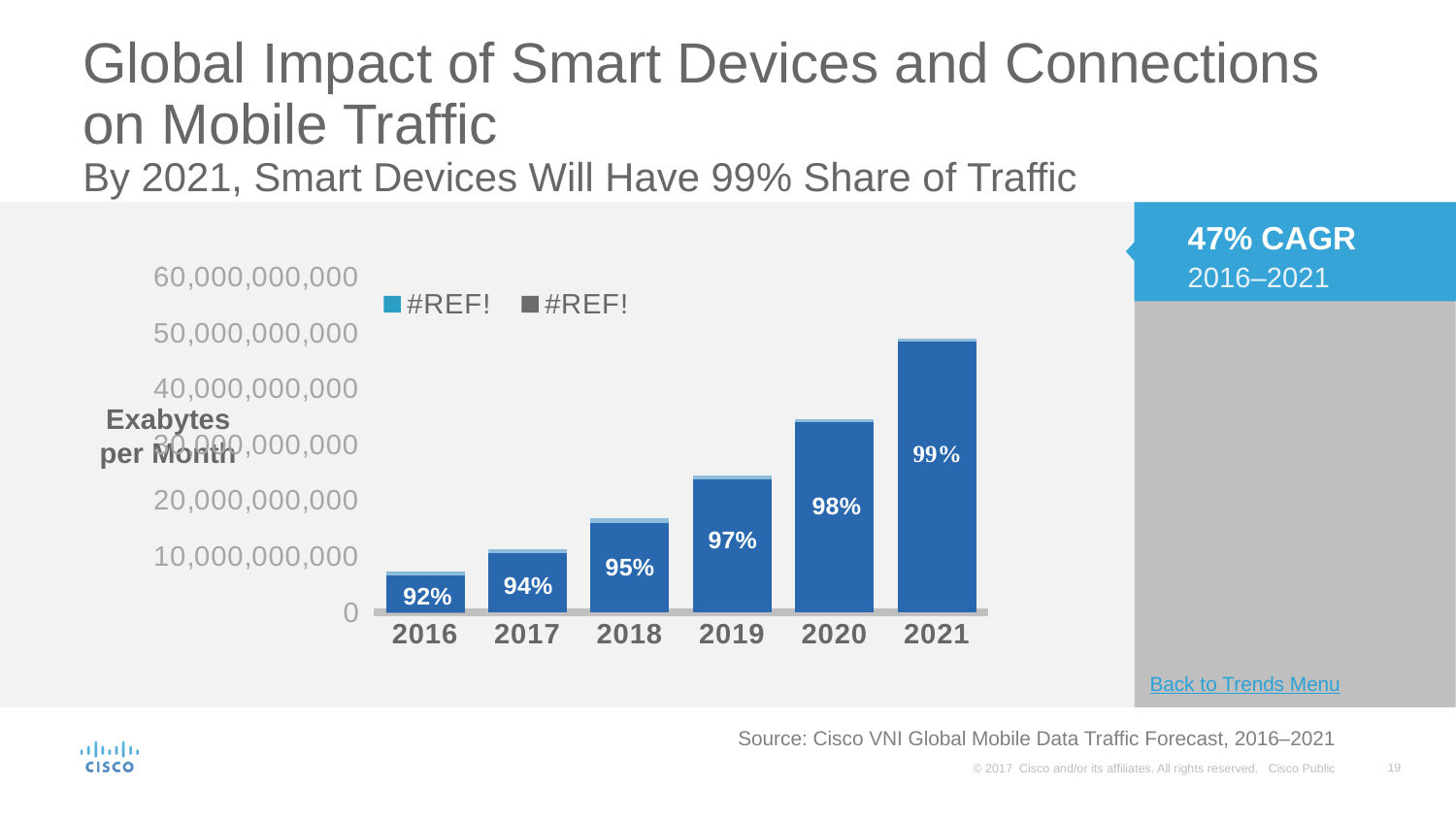
Which year has the tallest bar? 2021 How many series does the legend list? 2 Is the value for 2021 greater or less than 40,000,000,000? greater What percentage label is shown on the 2021 bar? 99% What percentage label is shown on the 2016 bar? 92% Is the value for 2016 greater or less than 10,000,000,000? less What kind of chart is shown on the slide? Bar chart What percentage label is shown on the 2019 bar? 97% How many years are shown on the x axis? 6 What is the difference between the percentage labels for 2021 and 2016? 7 percentage points Which year has the shortest bar? 2016 Which bar is taller, 2018 or 2020? 2020